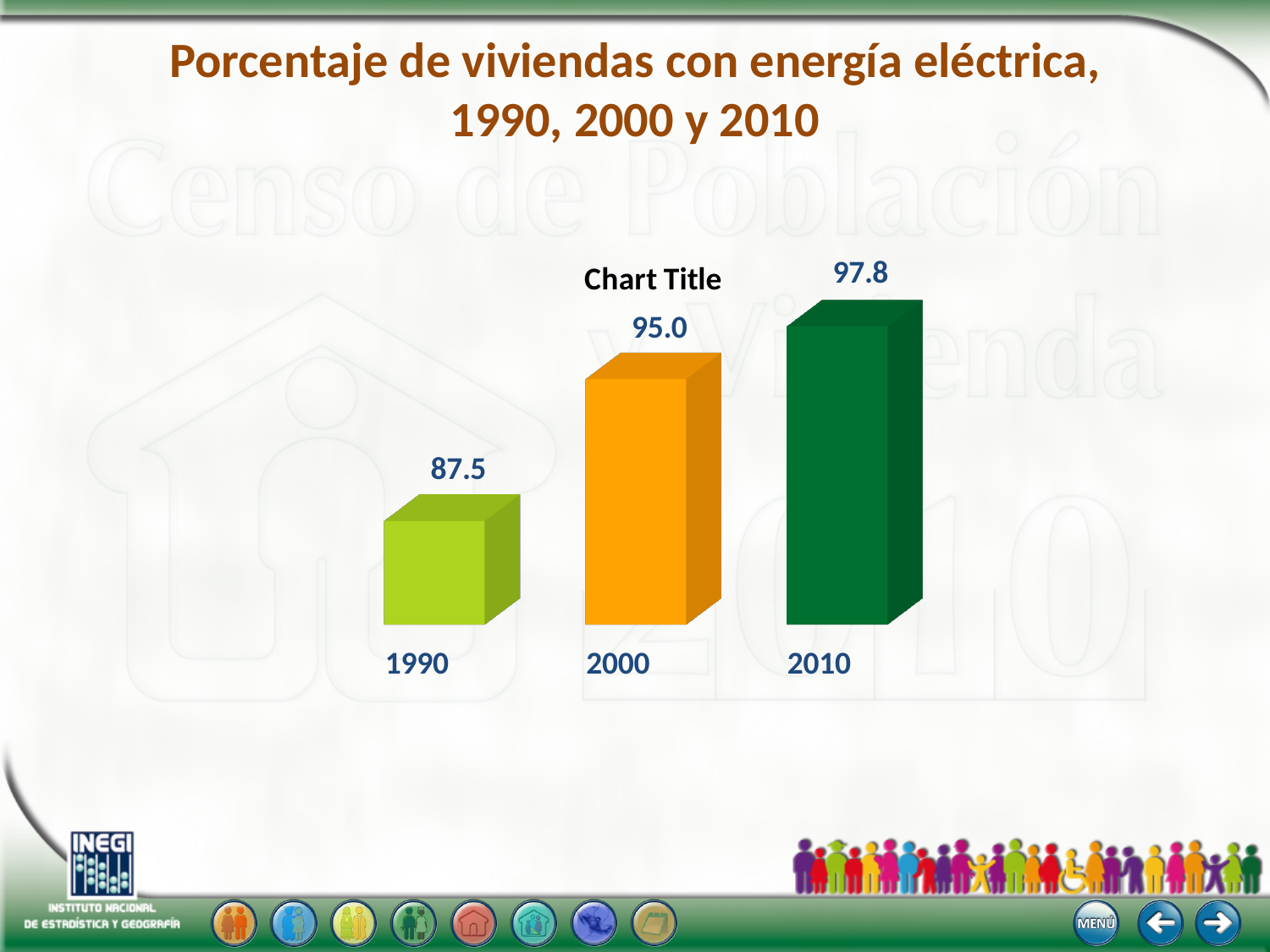
What kind of chart is shown on the slide? bar chart What is the difference between the values for 2000 and 1990? 7.5 What is the value for 2010? 97.8 What is the value for 2000? 95.0 Which is larger, the value for 2000 or the value for 2010? 2010 Do the values rise or fall from 1990 to 2010? rise What colour is the bar for 2000? orange How many years are shown in the chart? 3 Which year has the lowest value? 1990 What is the difference between the values for 2010 and 1990? 10.3 Which year has the highest value? 2010 What is the value for 1990? 87.5